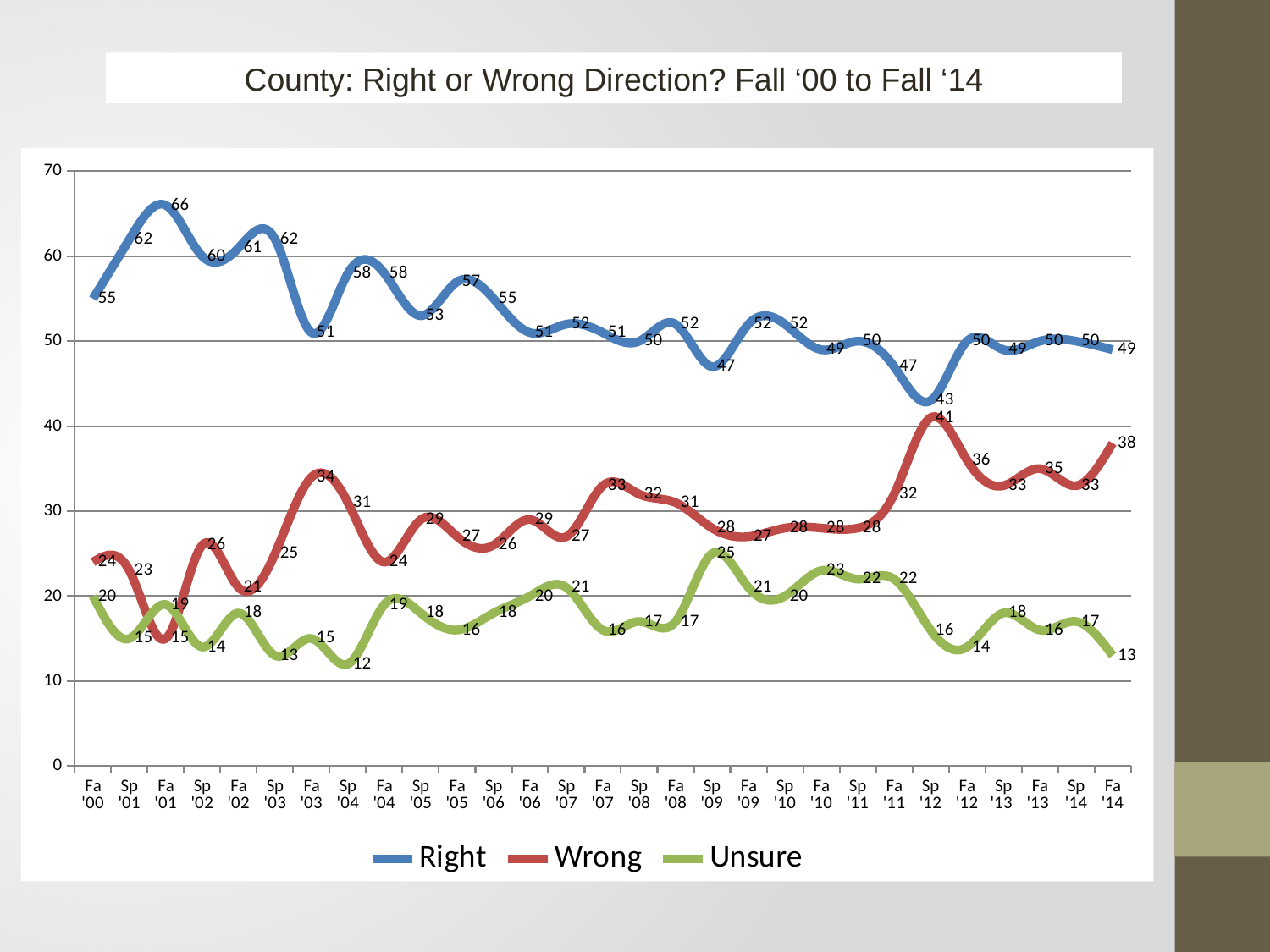
What is the difference between the Right and Wrong values at Fa '14? 11 At which survey period does the Unsure series reach its lowest value? Sp '04 What is the title of the chart? County: Right or Wrong Direction? Fall '00 to Fall '14 At which survey period does the Right series reach its lowest value? Sp '12 What is the value of the Wrong series at Sp '12? 41 What is the value of the Right series at Fa '01? 66 Which is larger at Fa '03: the Right value or the Wrong value? Right What type of chart is shown on the slide? line chart At which survey period does the Wrong series reach its highest value? Sp '12 Does the Right series generally rise or fall from Fa '00 to Fa '14? fall How many series does the legend list? 3 What is the value of the Unsure series at Sp '09? 25